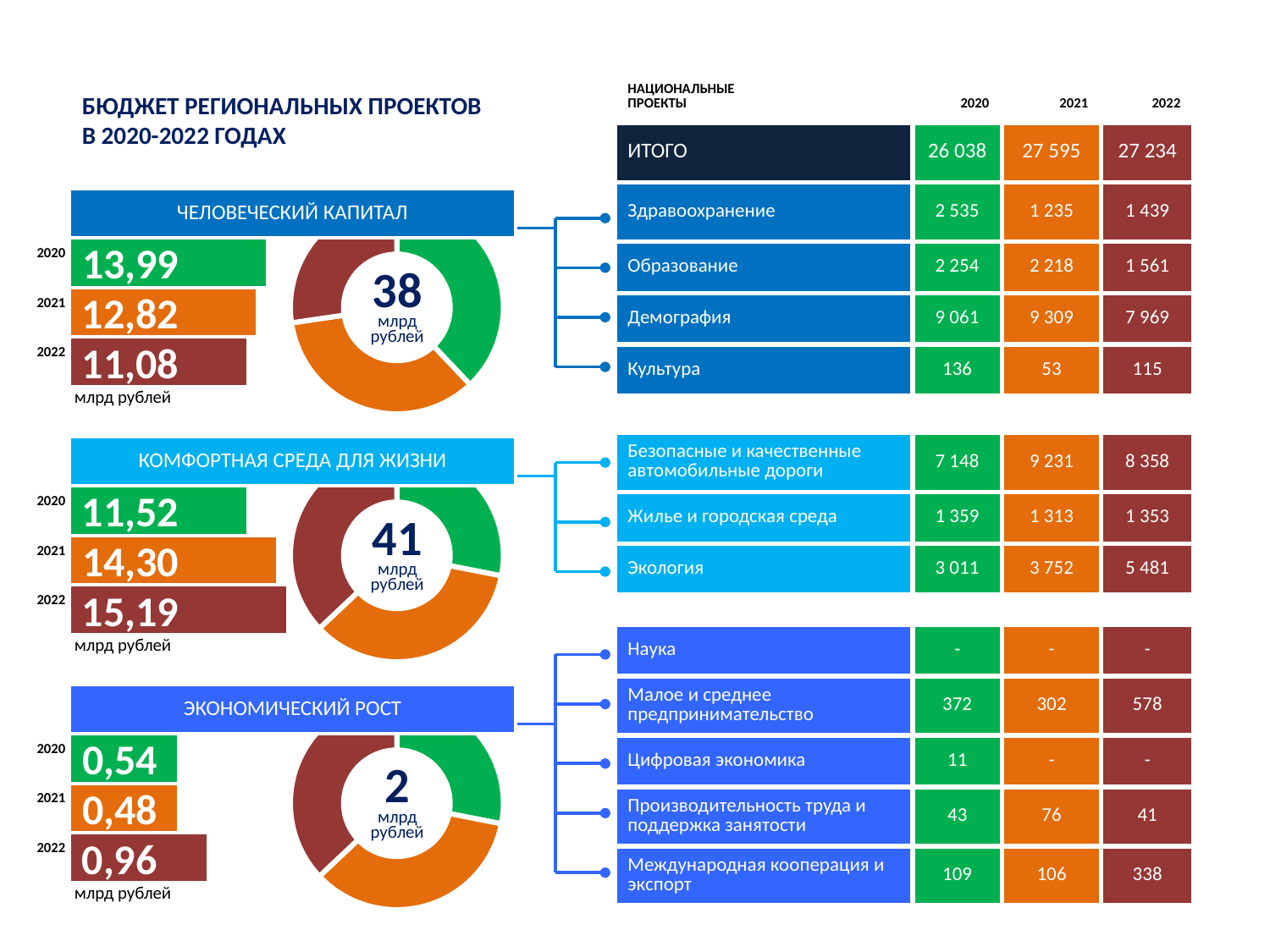
In the КОМФОРТНАЯ СРЕДА ДЛЯ ЖИЗНИ bar chart, what is the value for 2021? 14,30 What total is shown in the centre of the donut chart next to КОМФОРТНАЯ СРЕДА ДЛЯ ЖИЗНИ? 41 млрд рублей In the КОМФОРТНАЯ СРЕДА ДЛЯ ЖИЗНИ bar chart, what is the difference between the 2022 and 2020 values? 3,67 In the ЧЕЛОВЕЧЕСКИЙ КАПИТАЛ bar chart, what is the difference between the 2020 and 2021 values? 1,17 In the ЭКОНОМИЧЕСКИЙ РОСТ bar chart, what is the value for 2022? 0,96 In the ЧЕЛОВЕЧЕСКИЙ КАПИТАЛ bar chart, what is the value for 2020? 13,99 In the КОМФОРТНАЯ СРЕДА ДЛЯ ЖИЗНИ bar chart, which year has the highest value? 2022 In the ЧЕЛОВЕЧЕСКИЙ КАПИТАЛ bar chart, which year has the lowest value? 2022 In the ЧЕЛОВЕЧЕСКИЙ КАПИТАЛ bar chart, do the values rise or fall from 2020 to 2022? fall In the ЭКОНОМИЧЕСКИЙ РОСТ bar chart, which is larger, the value for 2020 or for 2021? 2020 How many bars are in the ЭКОНОМИЧЕСКИЙ РОСТ bar chart? 3 In the ЭКОНОМИЧЕСКИЙ РОСТ bar chart, which year has the lowest value? 2021